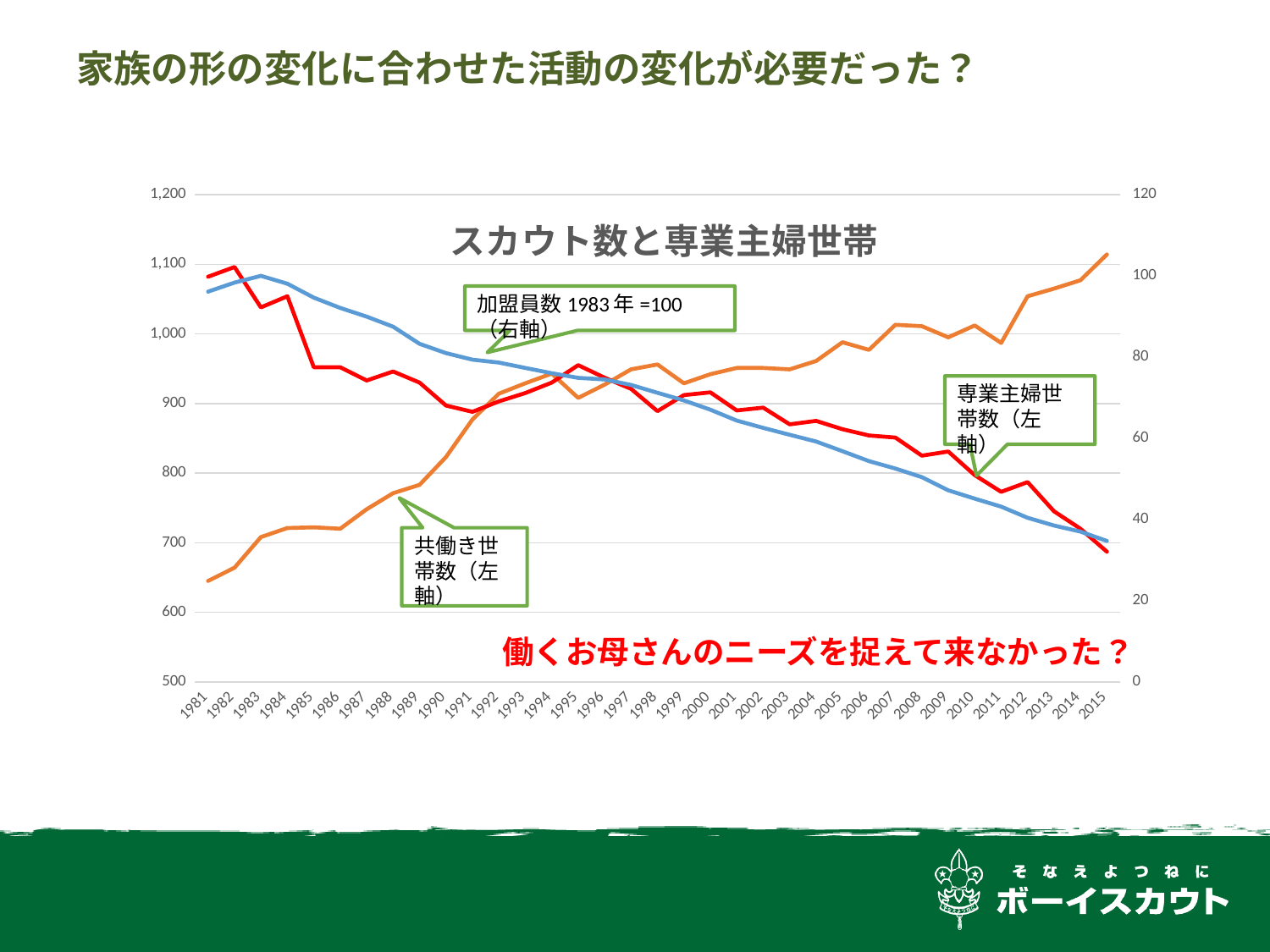
Does the 加盟員数 line rise or fall from 1983 to 2015? fall How many data series are plotted in the chart? 3 Which axis does the 加盟員数 series use, according to its callout? 右軸 (right axis) How many years are shown along the x axis of the chart? 35 Is the value for 共働き世帯数 in 1981 greater or less than 700? less What is the title of the chart? スカウト数と専業主婦世帯 Is the value for 加盟員数 in 2015 on the right axis greater or less than 40? less In 2015, which is higher, 共働き世帯数 or 専業主婦世帯数? 共働き世帯数 Is the value for 専業主婦世帯数 in 1981 greater or less than 1,000? greater Does the 専業主婦世帯数 line rise or fall from 1981 to 2015? fall What kind of chart is shown on the slide? line chart Does the 共働き世帯数 line rise or fall from 1981 to 2015? rise